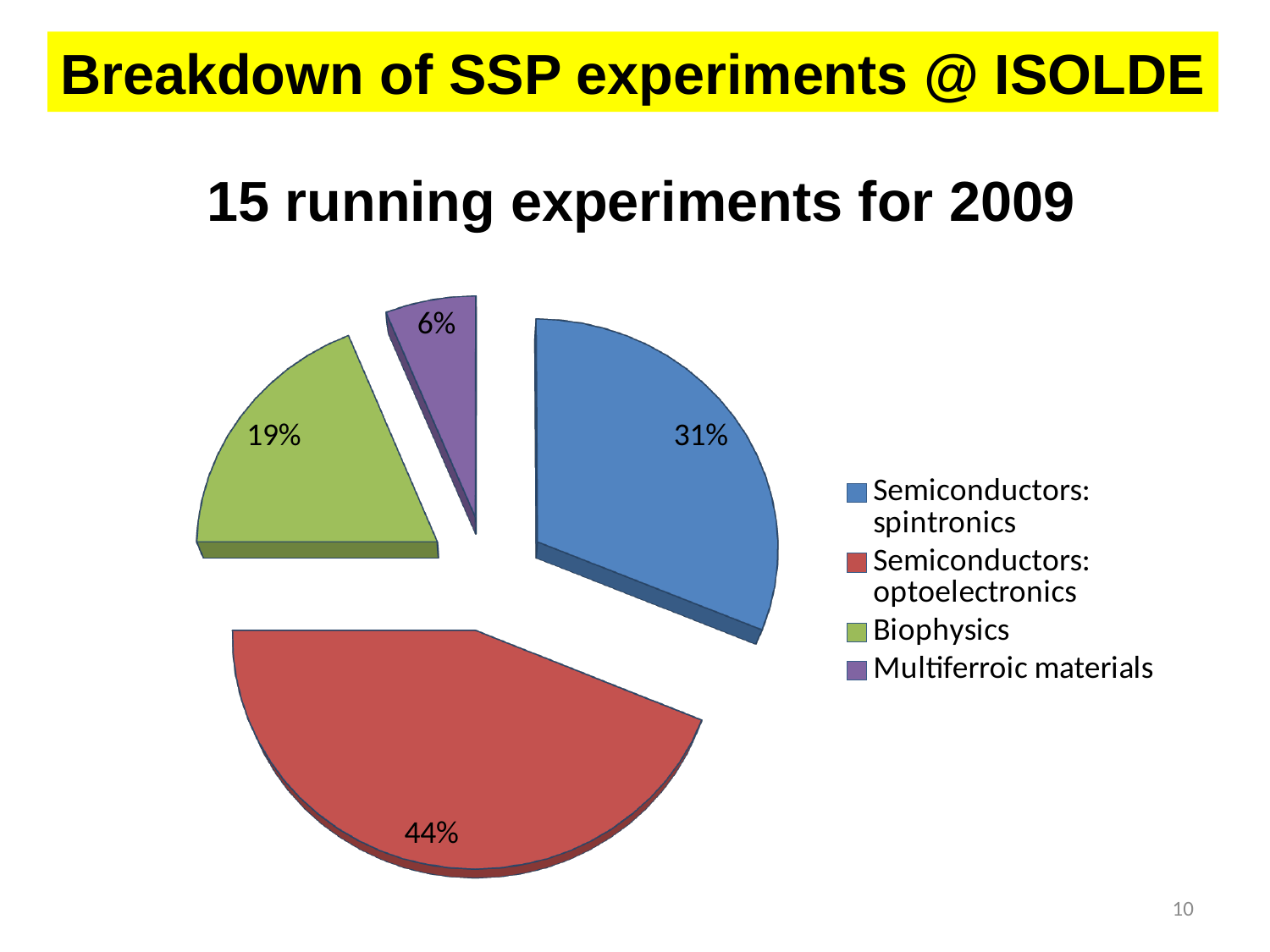
What colour is the slice for Biophysics? green What share of the pie does Semiconductors: optoelectronics have? 44% Which is larger, the share for Biophysics or the share for Multiferroic materials? Biophysics How many running experiments for 2009 does the slide say the chart covers? 15 What share of the pie does Semiconductors: spintronics have? 31% Which category has the largest slice of the pie? Semiconductors: optoelectronics Which category has the smallest slice of the pie? Multiferroic materials What is the difference in percentage points between Semiconductors: optoelectronics and Semiconductors: spintronics? 13 What share of the pie does Biophysics have? 19% What kind of chart is shown on the slide? pie chart How many categories does the pie chart show? 4